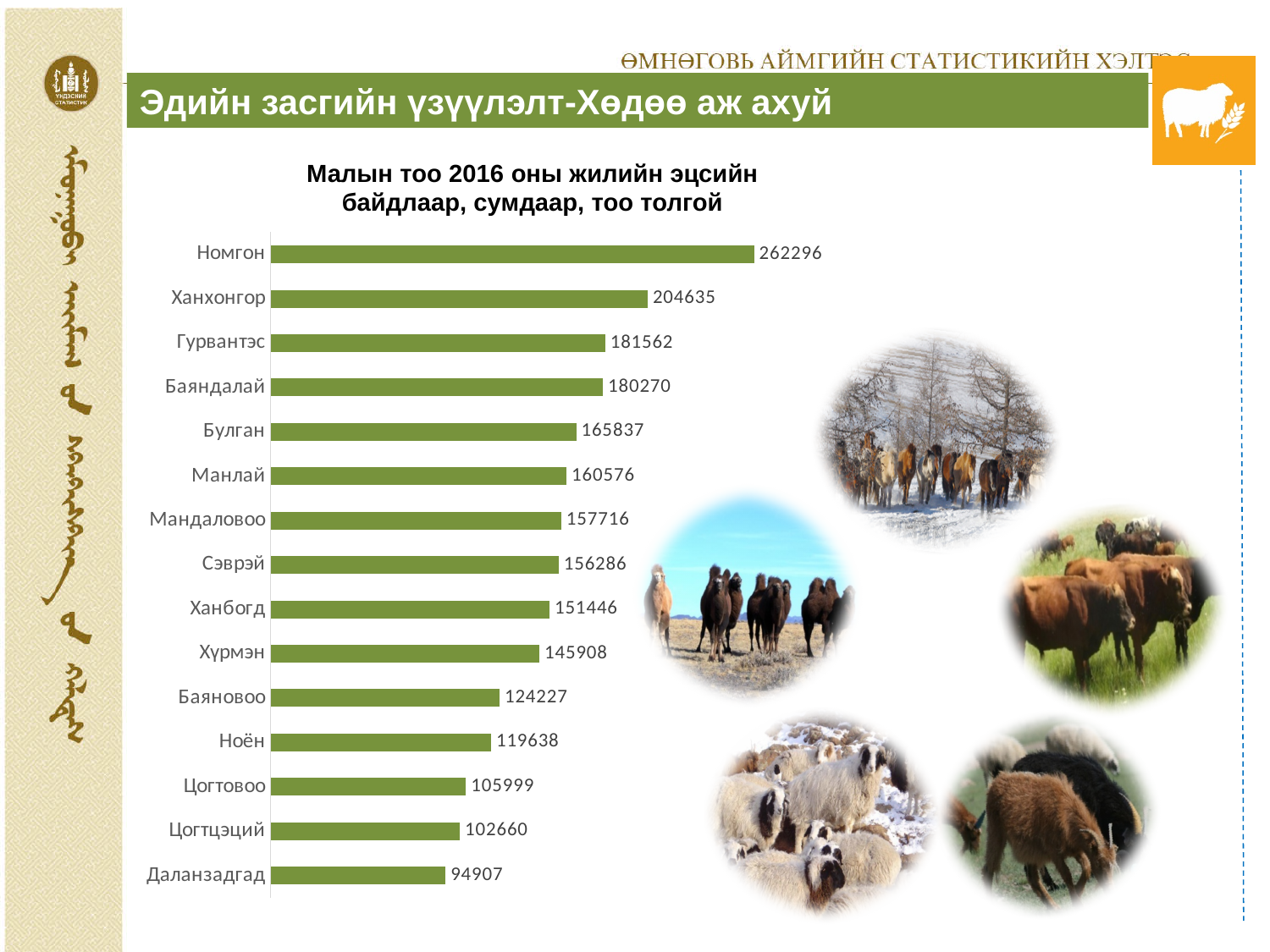
Which has a larger value, Булган or Манлай? Булган Which soum has the highest livestock count? Номгон Which has a larger value, Цогтовоо or Даланзадгад? Цогтовоо What is the value shown for Ханбогд? 151446 What is the difference between the values for Баяновоо and Ноён? 4589 What is the title of the chart? Малын тоо 2016 оны жилийн эцсийн байдлаар, сумдаар, тоо толгой What is the livestock count for Номгон? 262296 What is the value shown for Цогтцэций? 102660 What is the difference between the values for Номгон and Ханхонгор? 57661 How many soums are shown in the chart? 15 What type of chart is shown on the slide? Bar chart Which soum has the lowest livestock count? Даланзадгад